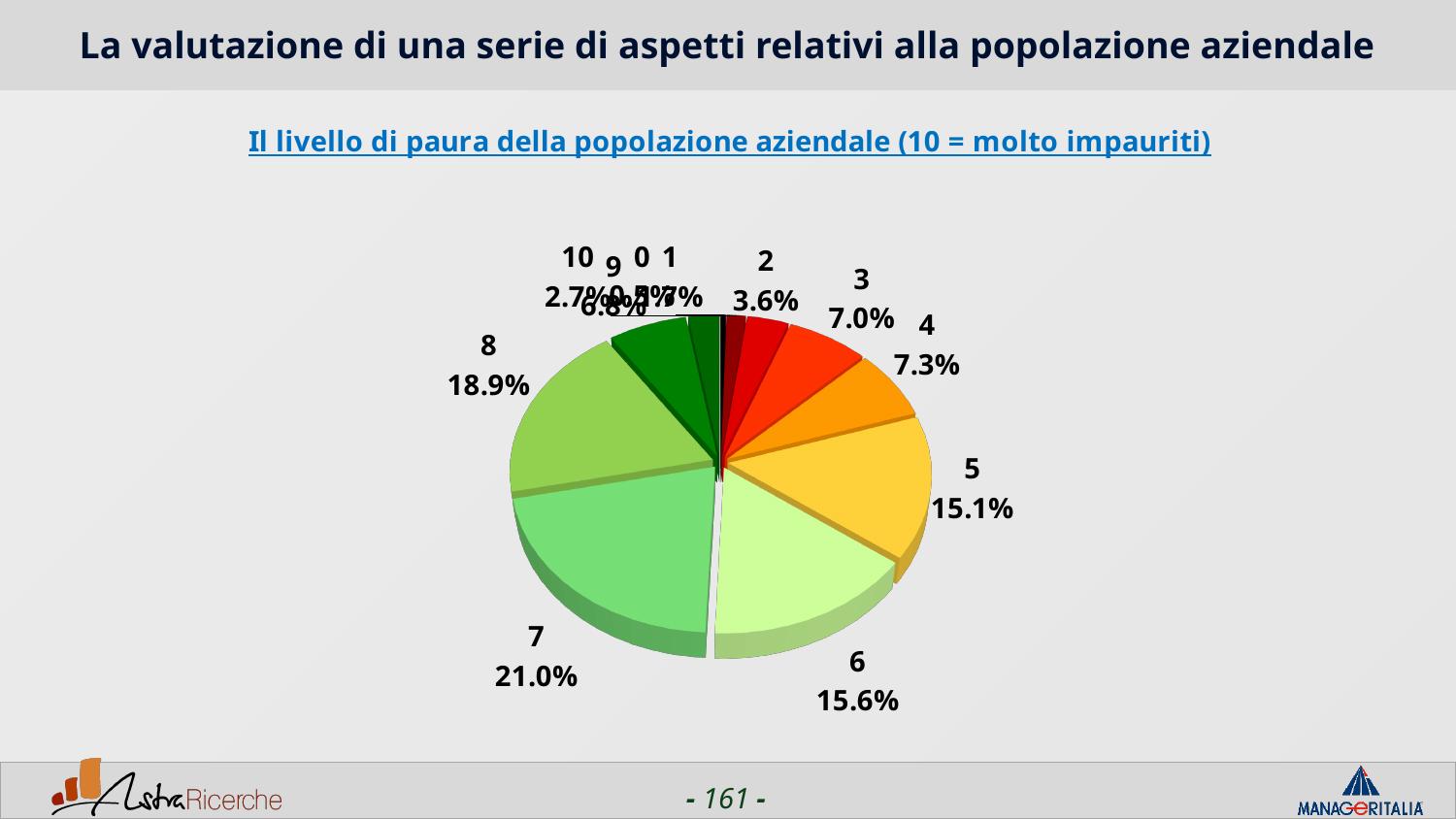
What percentage is shown for fear level 2? 3.6% What percentage is shown for fear level 5? 15.1% What kind of chart is shown on the slide? pie chart What is the title of the chart? Il livello di paura della popolazione aziendale (10 = molto impauriti) What is the difference between the shares for fear level 7 and fear level 8? 2.1% What percentage is shown for fear level 10? 2.7% What percentage is shown for fear level 8? 18.9% Which has the larger share, fear level 3 or fear level 4? 4 What percentage is shown for fear level 7? 21.0% Which fear level has the largest share of the pie? 7 What is the difference between the shares for fear level 6 and fear level 5? 0.5% How many fear-level categories are labelled on the pie chart? 11